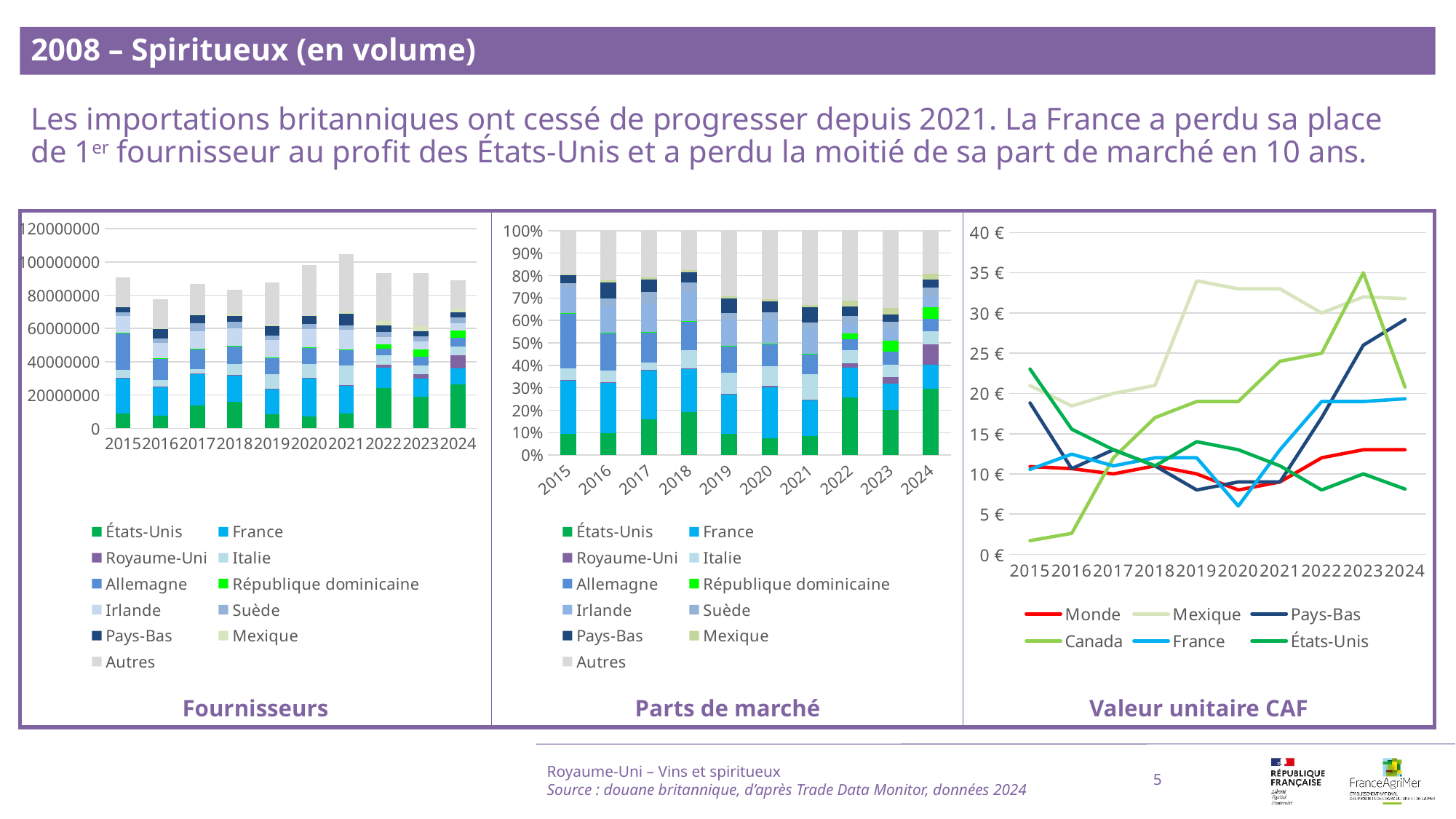
In the 'Fournisseurs' chart, which year has the tallest stacked bar? 2021 In the 'Fournisseurs' chart, which year has the shortest stacked bar? 2016 In the 'Fournisseurs' chart, is the total for 2021 greater or less than 100000000? greater In the 'Valeur unitaire CAF' chart, how many series does the legend list? 6 In the 'Valeur unitaire CAF' chart, does the Canada line rise or fall from 2015 to 2023? rise In the 'Valeur unitaire CAF' chart, is the value for Canada in 2023 greater or less than 30 €? greater In the 'Valeur unitaire CAF' chart, which series has the lowest value in 2015? Canada In the 'Fournisseurs' chart, how many years are shown on the x axis? 10 In the 'Fournisseurs' chart, how many series does the legend list? 11 What kind of chart is the 'Valeur unitaire CAF' chart? line chart In the 'Valeur unitaire CAF' chart, is the value for Mexique in 2015 greater or less than 5 €? greater What kind of chart is the 'Fournisseurs' chart? bar chart